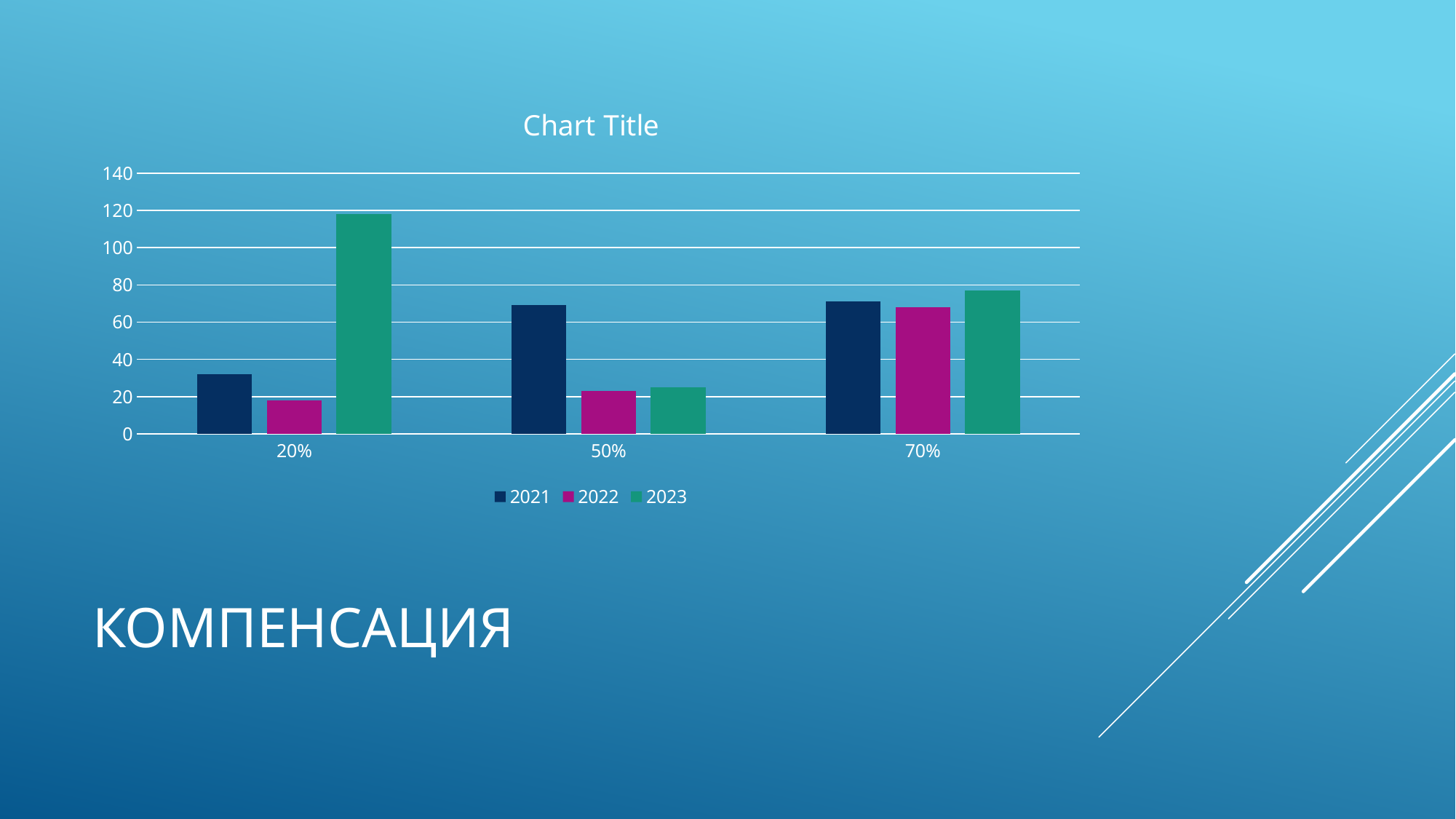
How many categories are shown on the x axis? 3 Is the value for 2021 at 50% greater or less than 60? greater What kind of chart is shown on the slide? bar chart In the 20% category, which is larger, the value for 2021 or the value for 2022? 2021 What is the title of the chart? Chart Title How many series does the legend list? 3 For the 2022 series, which category has the highest value? 70% Which series is shown in green in the legend? 2023 For the 2023 series, which category has the highest value? 20% Is the value for 2023 at 20% greater or less than 100? greater For the 2021 series, which category has the lowest value? 20% For the 2023 series, which category has the lowest value? 50%